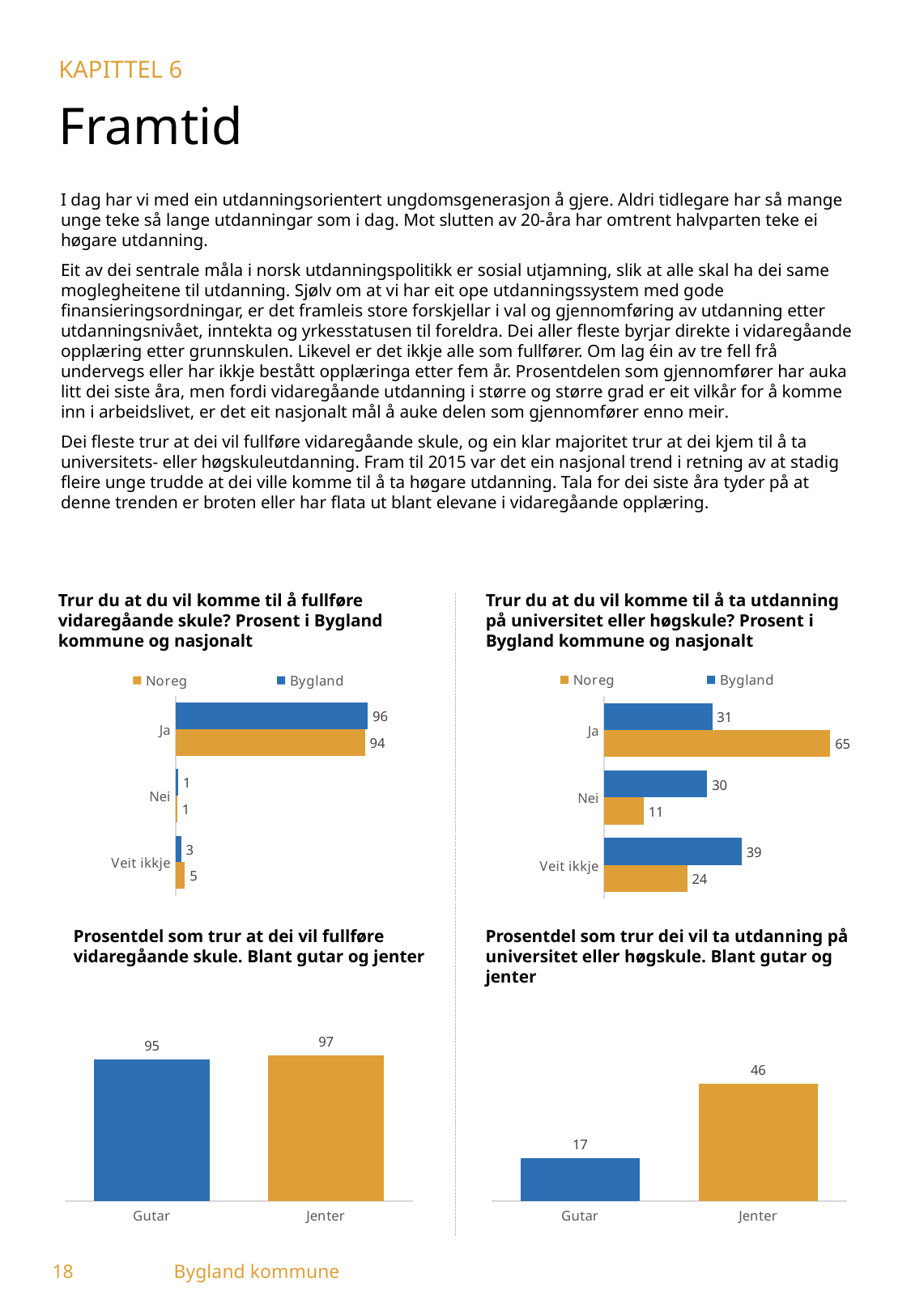
In the top-left chart (Trur du at du vil komme til å fullføre vidaregåande skule?), what is the value for Bygland for 'Ja'? 96 In the top-right chart (Trur du at du vil komme til å ta utdanning på universitet eller høgskule?), which category has the highest value for Bygland? Veit ikkje In the bottom-right chart (Prosentdel som trur dei vil ta utdanning på universitet eller høgskule), which category has the lowest value? Gutar In the top-right chart (Trur du at du vil komme til å ta utdanning på universitet eller høgskule?), which is larger for 'Nei': Bygland or Noreg? Bygland In the top-right chart (Trur du at du vil komme til å ta utdanning på universitet eller høgskule?), what is the difference between Noreg and Bygland for 'Ja'? 34 In the bottom-left chart (Prosentdel som trur at dei vil fullføre vidaregåande skule), what kind of chart is it? Bar chart In the top-left chart (Trur du at du vil komme til å fullføre vidaregåande skule?), what is the value for Noreg for 'Veit ikkje'? 5 In the top-right chart (Trur du at du vil komme til å ta utdanning på universitet eller høgskule?), what is the value for Noreg for 'Ja'? 65 In the top-left chart (Trur du at du vil komme til å fullføre vidaregåande skule?), how many series does the legend list? 2 In the bottom-left chart (Prosentdel som trur at dei vil fullføre vidaregåande skule), what is the value for Jenter? 97 In the bottom-right chart (Prosentdel som trur dei vil ta utdanning på universitet eller høgskule), what is the difference between Jenter and Gutar? 29 In the top-right chart (Trur du at du vil komme til å ta utdanning på universitet eller høgskule?), how many categories are shown? 3